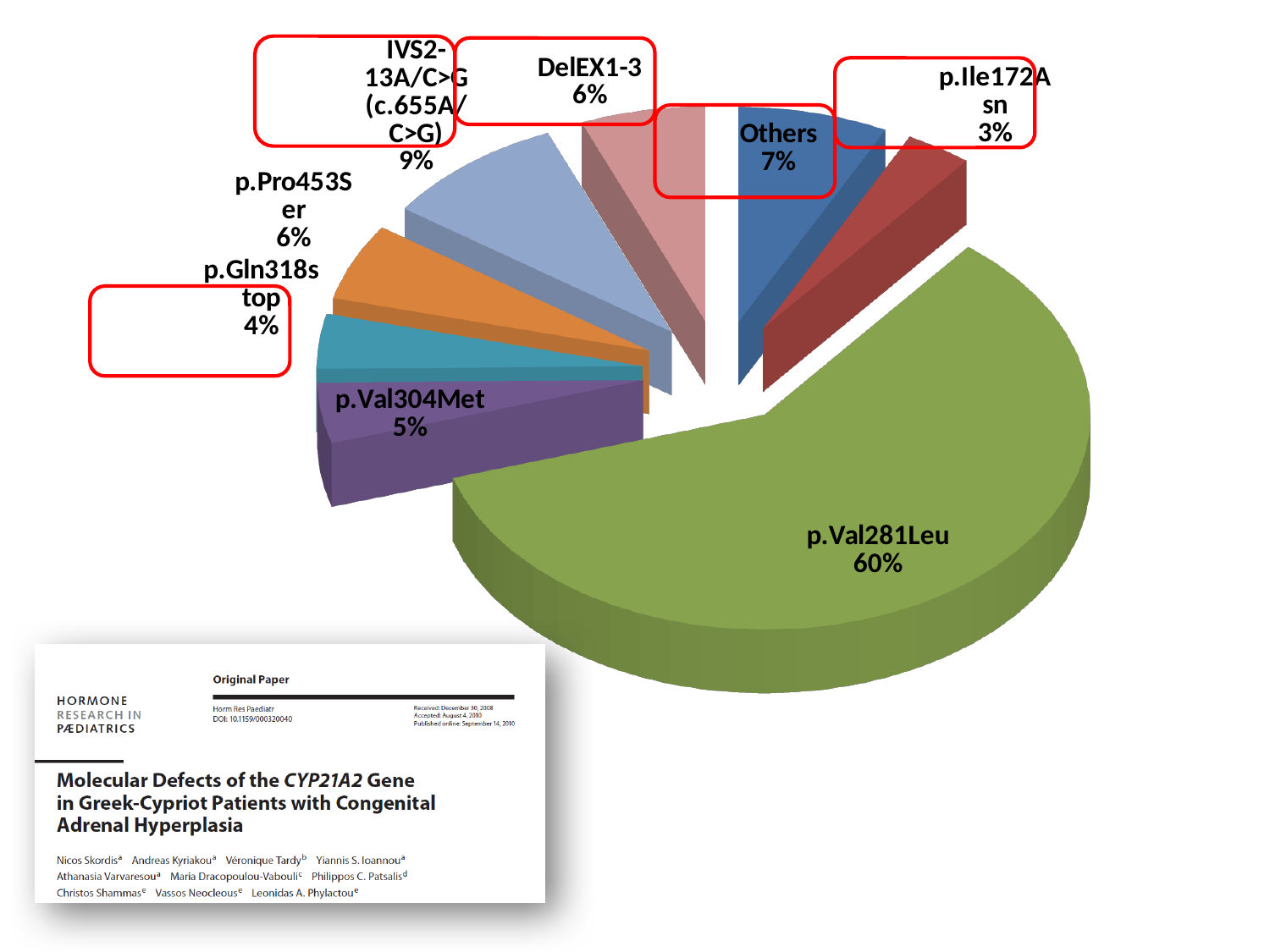
How many slices does the pie chart have? 8 Which slice of the pie is the smallest? p.Ile172Asn What is the value shown for the Others slice? 7% Which is larger, the share for p.Pro453Ser or the share for p.Gln318stop? p.Pro453Ser What percentage is shown for the IVS2-13A/C>G (c.655A/C>G) slice? 9% Which slice of the pie is the largest? p.Val281Leu What percentage is shown for p.Gln318stop? 4% What kind of chart is shown on the slide? pie chart What is the value shown for p.Val304Met? 5% What colour is the p.Val281Leu slice? green What is the difference in percentage points between p.Val281Leu and Others? 53 What share of the pie does p.Val281Leu represent? 60%